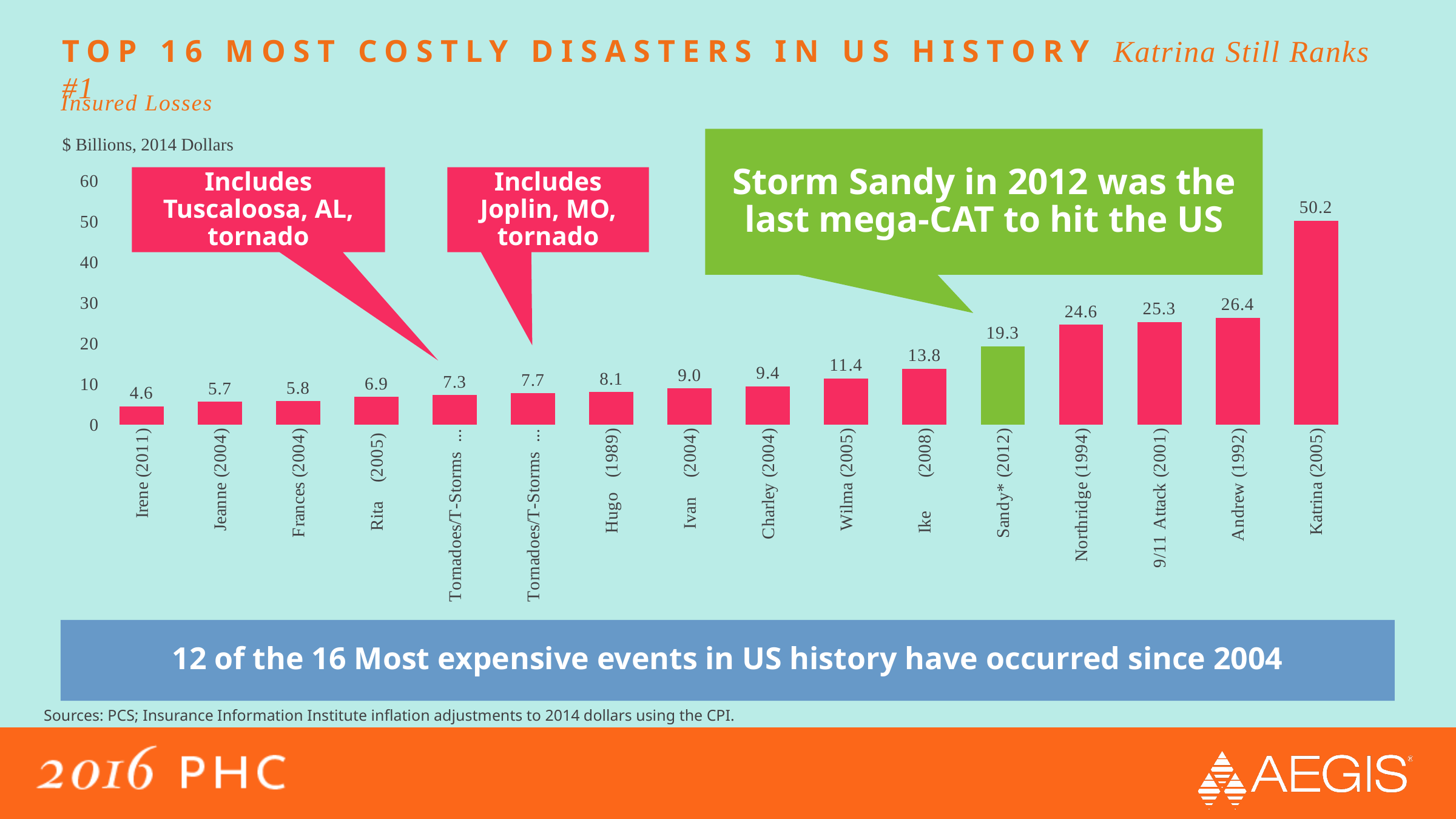
What is the difference between the insured losses for Katrina (2005) and Andrew (1992)? 23.8 Which disaster has the highest insured loss? Katrina (2005) How many disasters are shown in the chart? 16 What kind of chart is shown on the slide? Bar chart What is the insured loss value for Irene (2011)? 4.6 Is the value for 9/11 Attack (2001) greater or less than 20? greater Which disaster has the lowest insured loss? Irene (2011) What is the insured loss value for Northridge (1994)? 24.6 What is the insured loss value for Katrina (2005)? 50.2 Which bar is coloured green instead of pink? Sandy* (2012) What is the insured loss value for Sandy* (2012)? 19.3 Which has a larger insured loss, Ike (2008) or Wilma (2005)? Ike (2008)